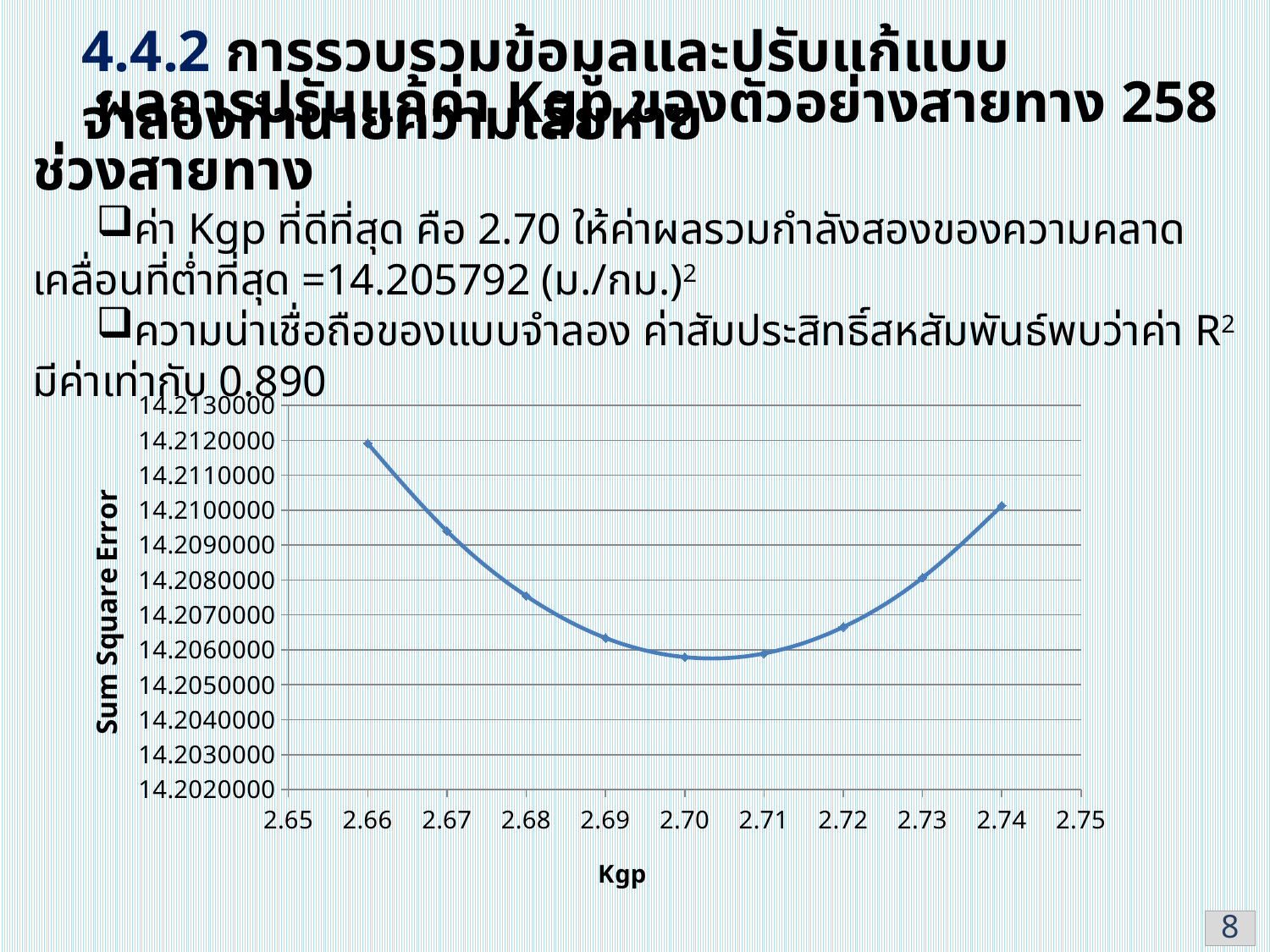
At which Kgp value is the Sum Square Error lowest? 2.70 Is the Sum Square Error at Kgp 2.73 greater or less than 14.2070000? greater Which has the larger Sum Square Error, Kgp 2.67 or Kgp 2.73? 2.67 What kind of chart is shown on the slide? line chart Is the Sum Square Error at Kgp 2.70 greater or less than 14.2070000? less How does the Sum Square Error change as Kgp increases from 2.66 to 2.74? It falls to a minimum at 2.70, then rises Is the Sum Square Error at Kgp 2.74 greater or less than 14.2110000? less How many data points are plotted on the chart? 9 At which Kgp value is the Sum Square Error highest? 2.66 Which has the larger Sum Square Error, Kgp 2.68 or Kgp 2.72? 2.68 What is the title of the vertical axis of the chart? Sum Square Error